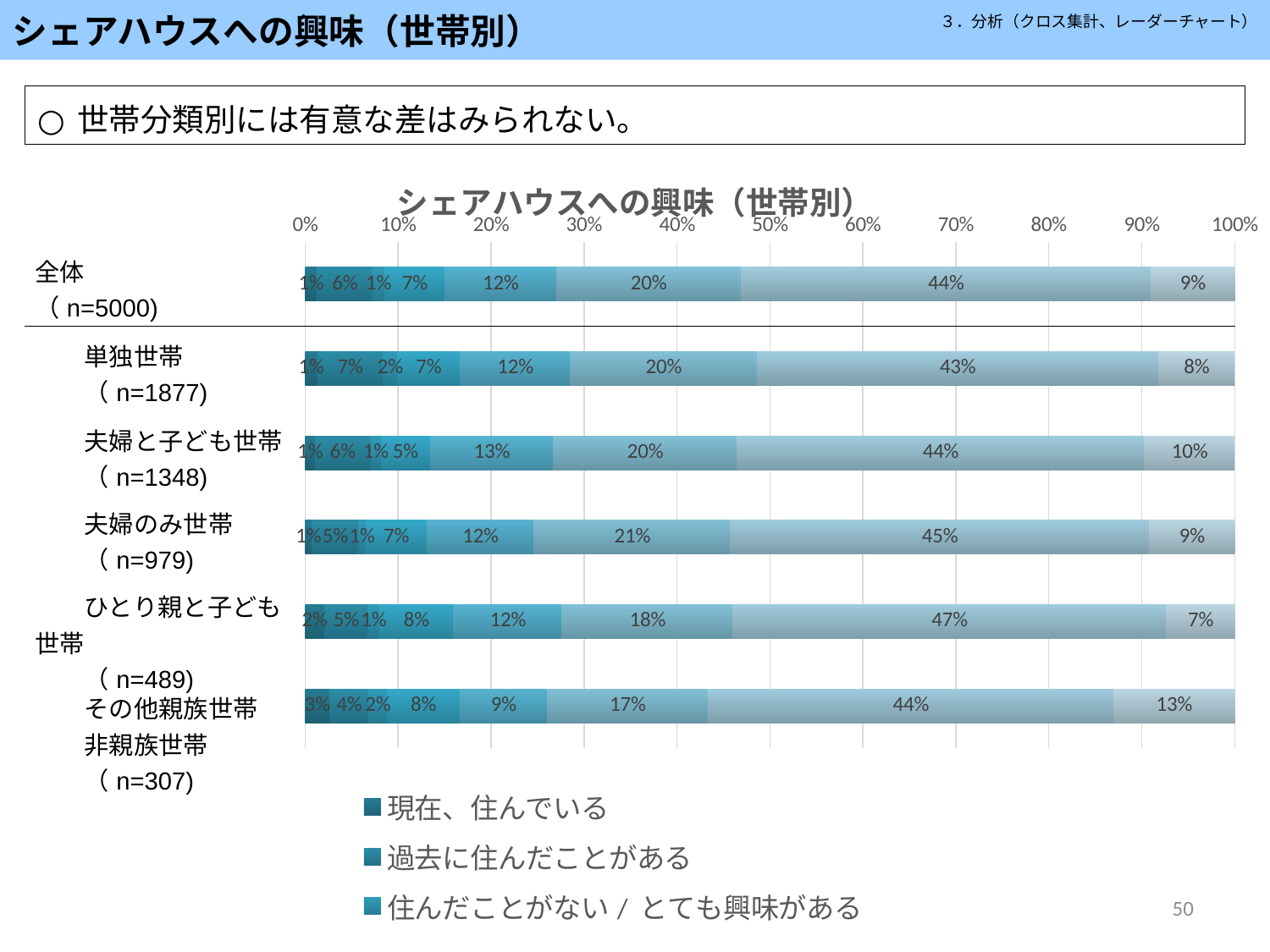
Which is larger, the 過去に住んだことがある value for 単独世帯 or for 夫婦のみ世帯? 単独世帯 What is the value of the rightmost segment in the ひとり親と子ども世帯 (n=489) bar? 7% What is the value of the largest segment in the 全体 (n=5000) bar? 44% What is the title of the chart? シェアハウスへの興味（世帯別） What is the value of the 過去に住んだことがある segment for 単独世帯 (n=1877)? 7% What is the value of the 現在、住んでいる segment for 全体 (n=5000)? 1% What is the difference between the rightmost segment of the 全体 bar (9%) and the rightmost segment of the ひとり親と子ども世帯 bar (7%)? 2 percentage points How many household category bars are plotted in the chart? 6 Which household category has the highest 過去に住んだことがある value? 単独世帯 What is the total of all segments in the 全体 (n=5000) stacked bar? 100% What is the value of the 住んだことがない / とても興味がある segment for 夫婦と子ども世帯 (n=1348)? 1% What type of chart is shown on the slide? Stacked bar chart